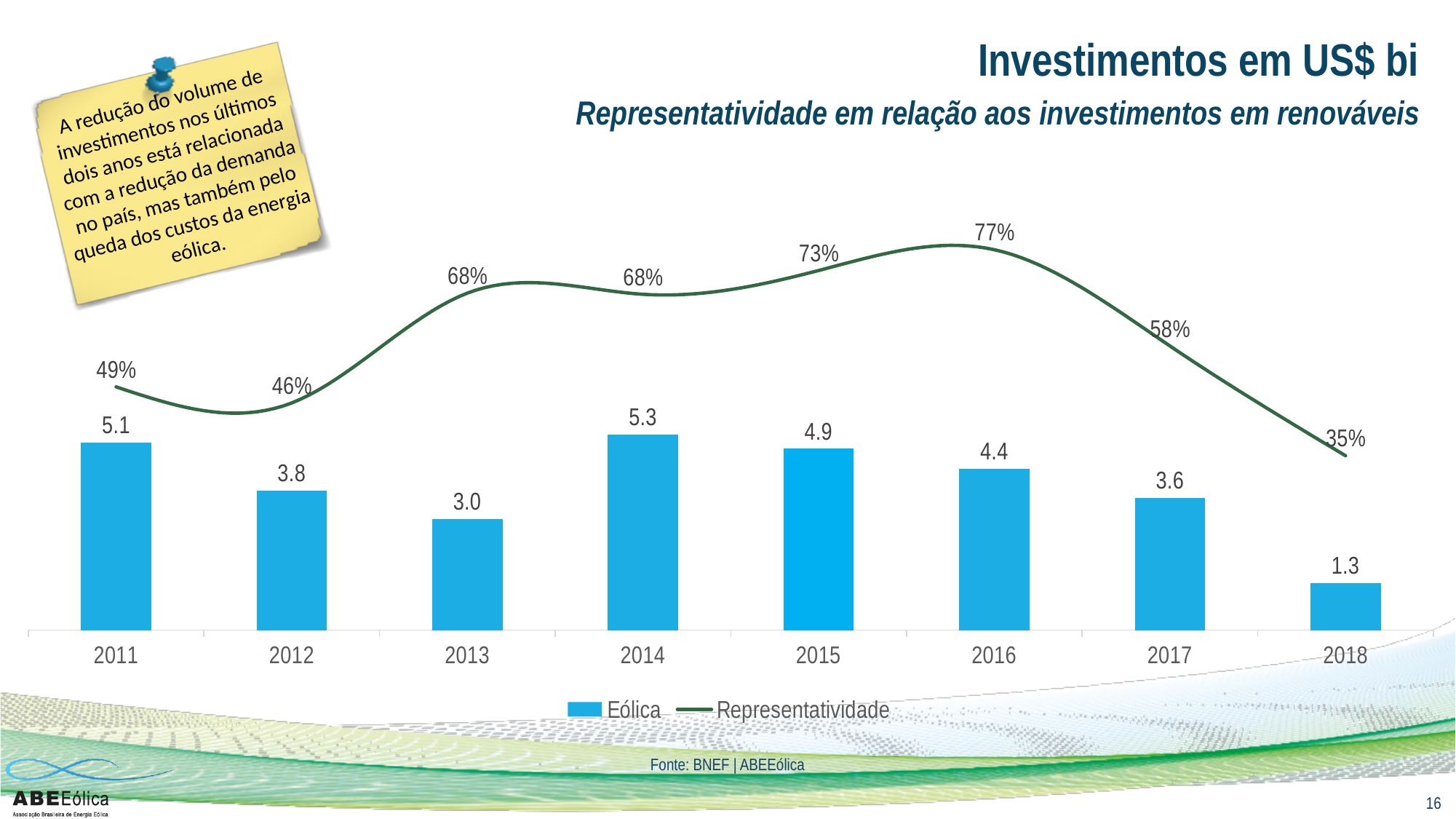
What is the source cited below the chart? BNEF | ABEEólica How many series does the legend list? 2 Which is larger, the Eólica investment in 2015 or in 2016? 2015 What kind of chart is used to show the Eólica series? Bar chart How many years are shown on the x axis? 8 What is the difference between the Eólica investment in 2011 and in 2018? 3.8 Which year has the lowest Representatividade value? 2018 What is the Representatividade value for 2016? 77% Which year has the highest Eólica investment? 2014 Does the Representatividade line rise or fall from 2016 to 2018? Fall What is the Eólica investment value for 2014? 5.3 What is the Eólica investment value for 2018? 1.3